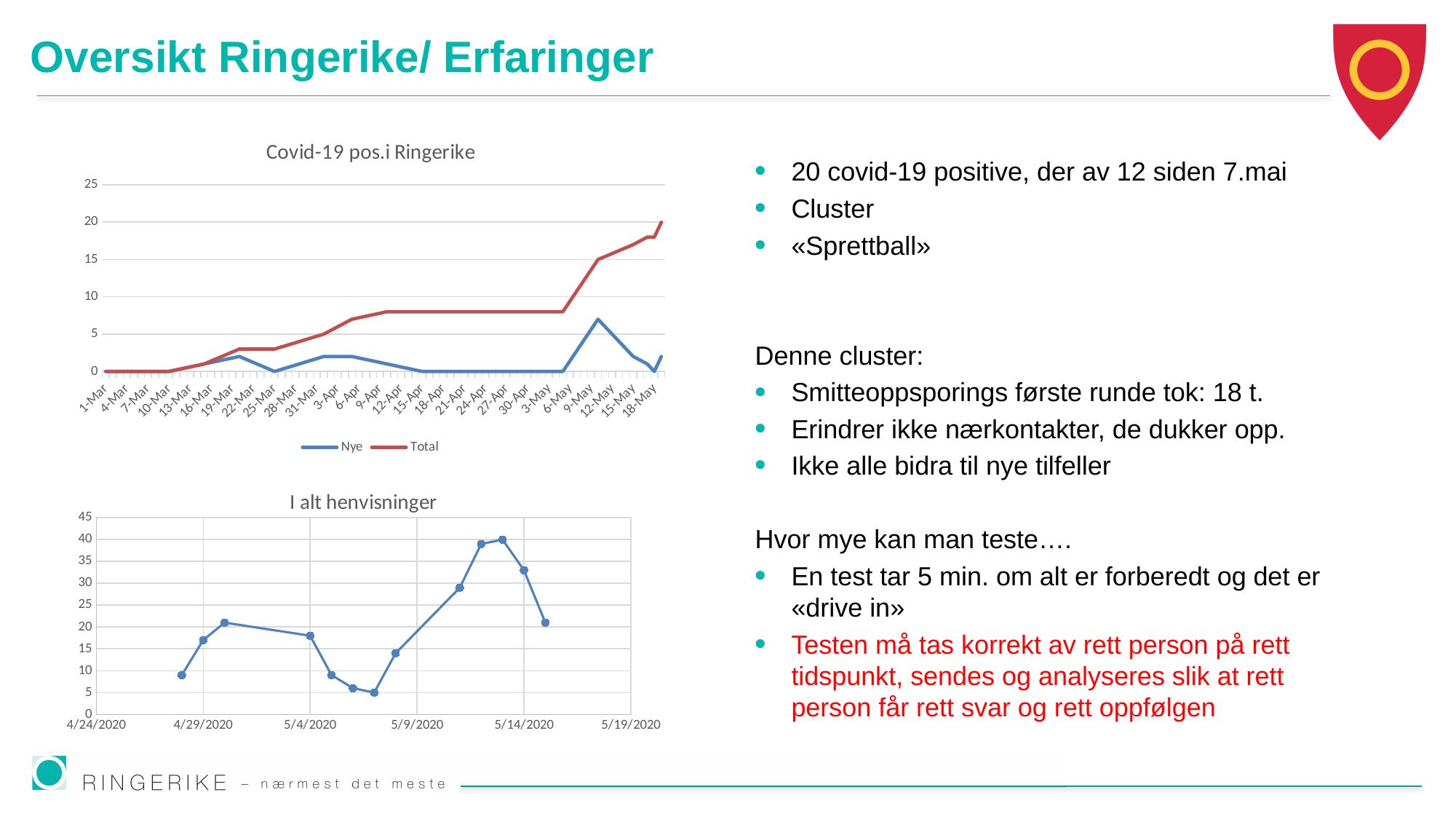
In the 'Covid-19 pos.i Ringerike' chart, does the Total series rise or fall from 1-Mar to the end of the period? rise In the 'I alt henvisninger' chart, is the value at 4/29/2020 greater or less than 20? less What kind of chart is the 'Covid-19 pos.i Ringerike' chart? line chart What are the two series named in the legend of the 'Covid-19 pos.i Ringerike' chart? Nye and Total How many data points are plotted in the 'I alt henvisninger' chart? 13 In the 'I alt henvisninger' chart, is the highest plotted value greater or less than 35? greater In the 'Covid-19 pos.i Ringerike' chart, which series has the larger value at 9-May, Nye or Total? Total In the 'Covid-19 pos.i Ringerike' chart, is the Total value at 18-May greater or less than 15? greater What kind of chart is the 'I alt henvisninger' chart? line chart What is the title of the upper chart on the slide? Covid-19 pos.i Ringerike How many series does the legend of the 'Covid-19 pos.i Ringerike' chart list? 2